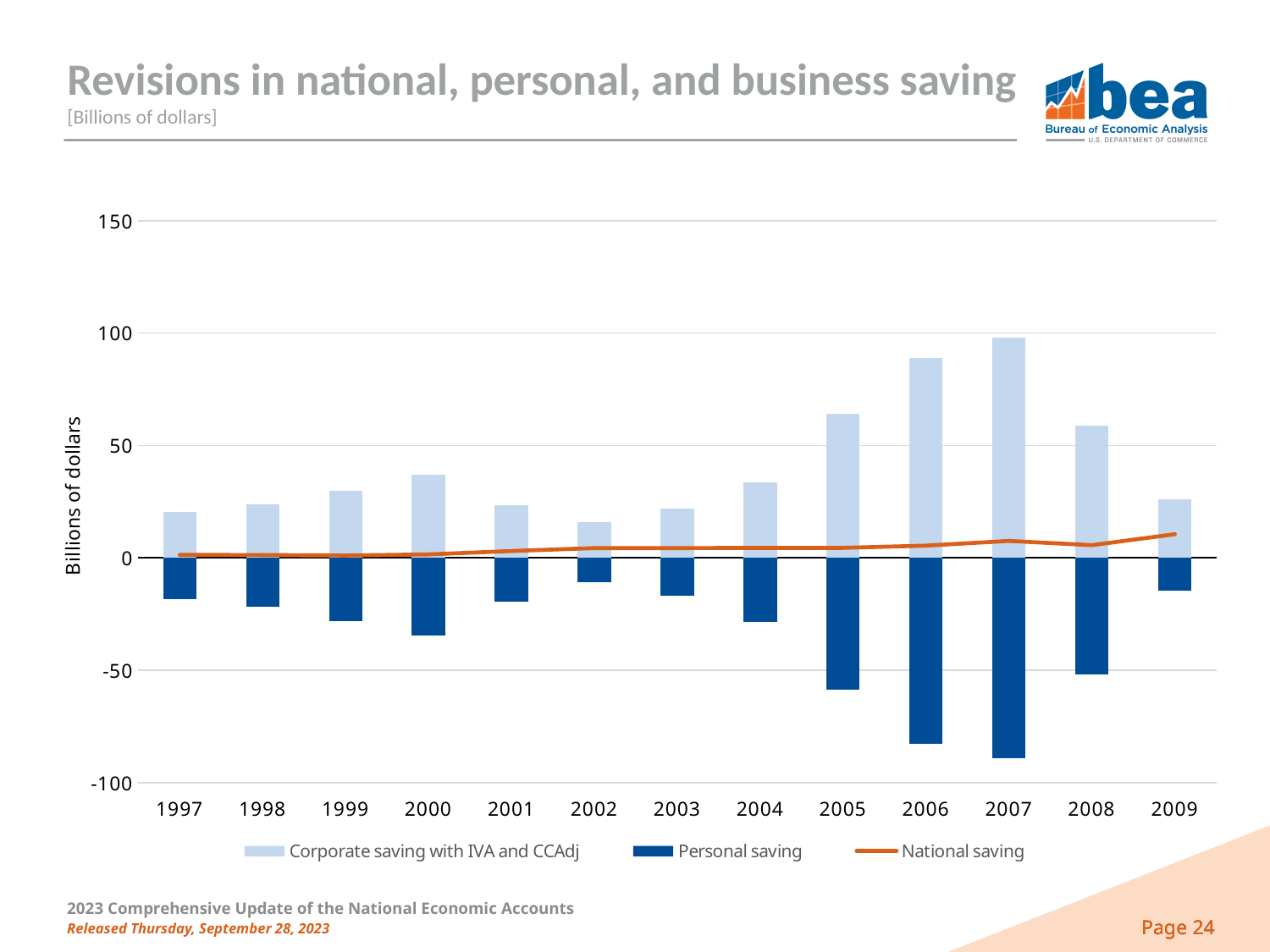
In which year is the Personal saving bar the most negative? 2007 Is the Corporate saving with IVA and CCAdj value for 2006 greater or less than 50? greater Which year has the larger Corporate saving with IVA and CCAdj bar, 2005 or 2008? 2005 How many series does the chart's legend list? 3 In which year is the Corporate saving with IVA and CCAdj bar the highest? 2007 How many years are shown on the x axis of the chart? 13 In which year is the Corporate saving with IVA and CCAdj bar the lowest? 2002 Is the Corporate saving with IVA and CCAdj value for 2009 greater or less than 50? less Is the Personal saving value for 2005 greater or less than -50? less Which series is shown by the light blue bars in the chart? Corporate saving with IVA and CCAdj What kind of chart is shown on the slide? A bar chart with a line series What is the title of the chart's vertical axis? Billions of dollars